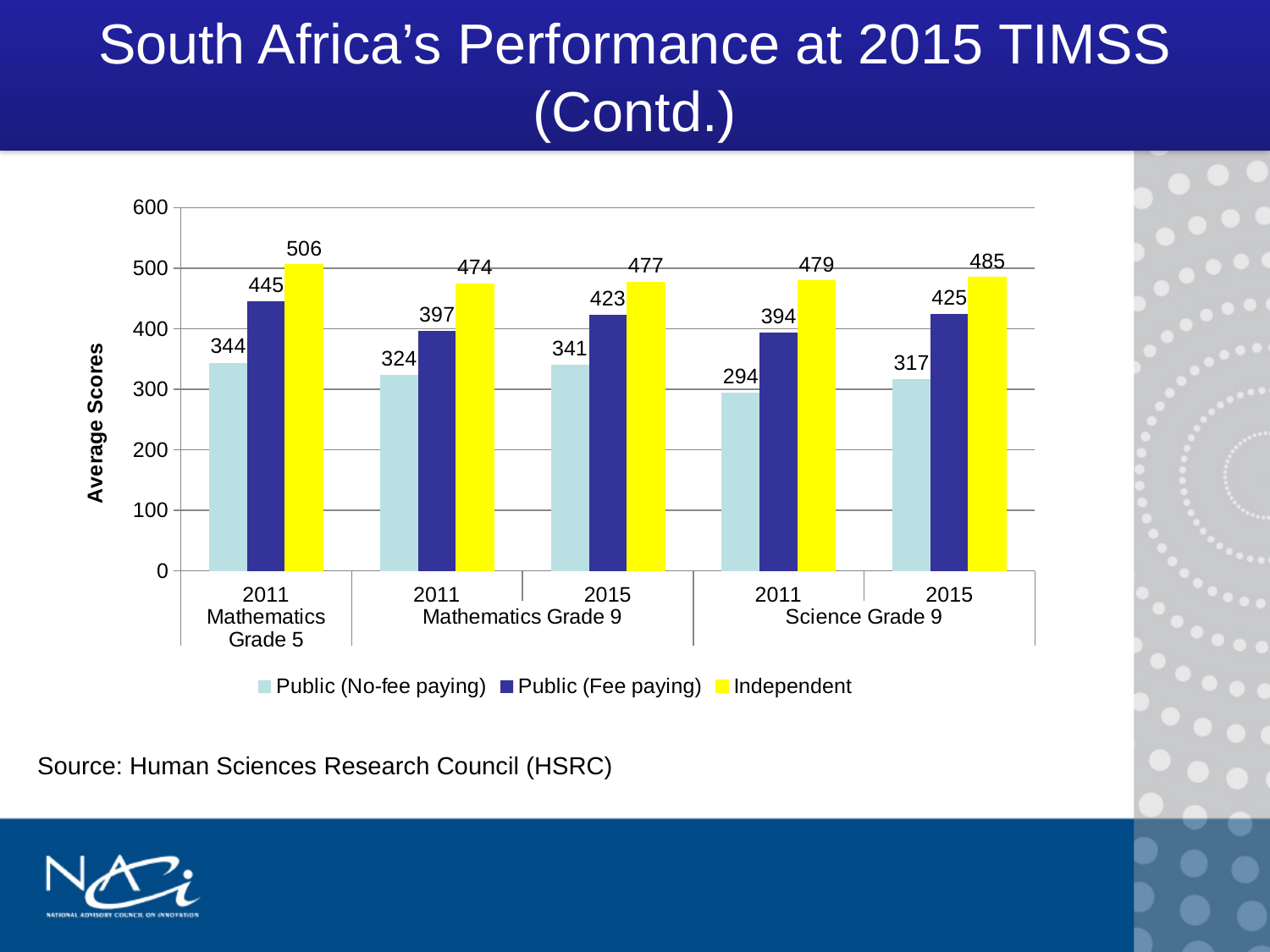
By how much did the Public (Fee paying) score in Mathematics Grade 9 change from 2011 to 2015? 26 How many series does the legend list? 3 What is the average score for Independent schools in 2015 Science Grade 9? 485 What is the average score for Public (Fee paying) schools in 2015 Mathematics Grade 9? 423 Which category has the highest Independent score? 2011 Mathematics Grade 5 How many category groups are shown on the x axis? 5 Which is larger: the Public (Fee paying) score in 2011 Mathematics Grade 5 or in 2015 Science Grade 9? 2011 Mathematics Grade 5 What type of chart is shown on the slide? Bar chart Is the Public (No-fee paying) score in 2015 Science Grade 9 greater or less than 400? less What is the average score for Public (No-fee paying) schools in 2011 Mathematics Grade 5? 344 What is the difference between the Independent and Public (No-fee paying) scores in 2011 Science Grade 9? 185 Which category has the lowest Public (No-fee paying) score? 2011 Science Grade 9